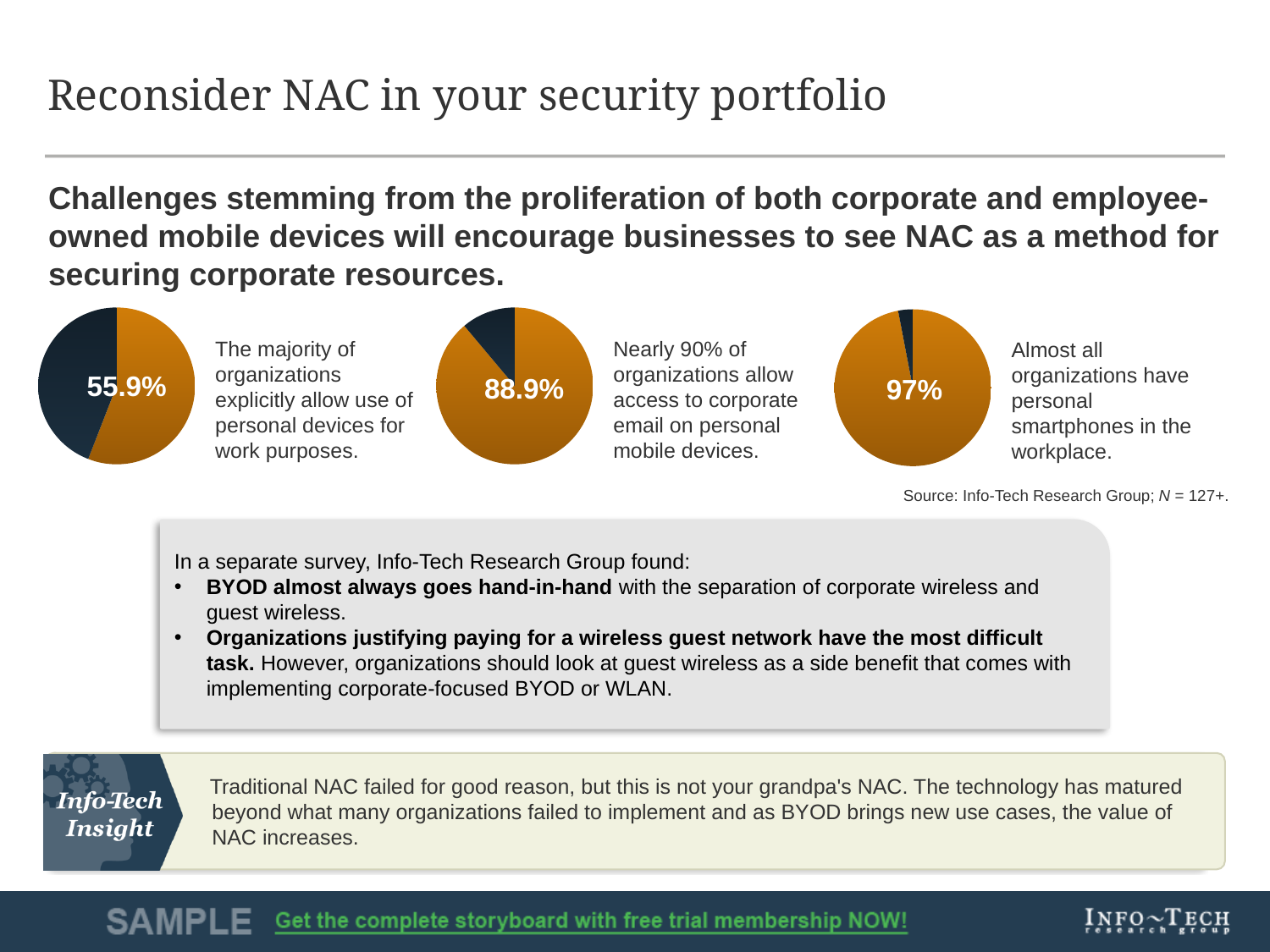
What kind of charts are the three charts in the middle of the slide? Pie charts How many pie charts are shown on the slide? 3 In the left pie chart, what percentage is printed in the centre? 55.9% Which of the three pie charts shows the lowest percentage? The left pie chart (55.9%) According to the text next to the right pie chart, what does the 97% figure represent? Organizations that have personal smartphones in the workplace Is the percentage shown in the left pie chart larger or smaller than the percentage shown in the right pie chart? Smaller How many slices does each pie chart have? 2 What colour is the larger slice in each of the three pie charts? Orange In the middle pie chart, what percentage is printed in the centre? 88.9% In the right pie chart, what percentage is printed in the centre? 97% Which of the three pie charts shows the highest percentage? The right pie chart (97%) What is the difference between the percentage in the middle pie chart and the percentage in the left pie chart? 33%